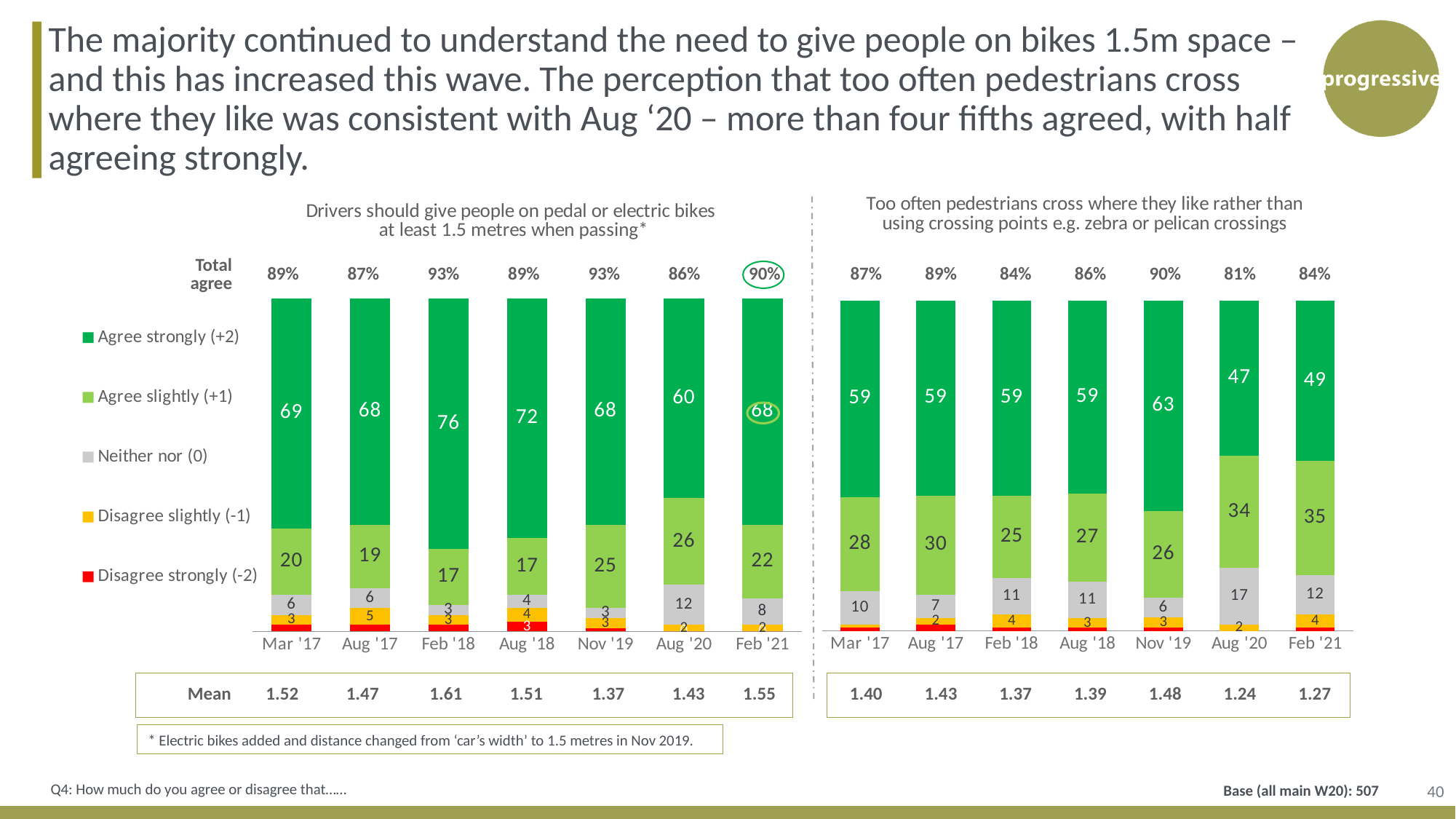
In the left chart about giving people on bikes 1.5 metres, what is the difference between the Agree strongly values for Feb '18 and Aug '20? 16 What type of chart is used for 'Too often pedestrians cross where they like rather than using crossing points'? Stacked bar chart In the chart 'Too often pedestrians cross where they like rather than using crossing points', what is the Agree slightly value for Feb '21? 35 In the chart 'Drivers should give people on pedal or electric bikes at least 1.5 metres when passing', what percentage agreed strongly in Feb '18? 76 In the left chart about giving people on bikes 1.5 metres, what is the Total agree figure for Feb '21? 90% How many waves (x-axis categories) are shown in the left chart about giving people on bikes 1.5 metres? 7 In the left chart about giving people on bikes 1.5 metres, which wave has the highest Agree strongly value? Feb '18 How many series does the legend list for the charts on this slide? 5 In the right chart about pedestrians crossing where they like, is the Agree slightly value larger in Aug '20 or in Nov '19? Aug '20 In the left chart about giving people on bikes 1.5 metres, what is the Neither nor (0) value for Aug '20? 12 In the right chart about pedestrians crossing where they like, which wave has the lowest Agree strongly value? Aug '20 In the right chart about pedestrians crossing where they like, what is the Mean value for Aug '20? 1.24